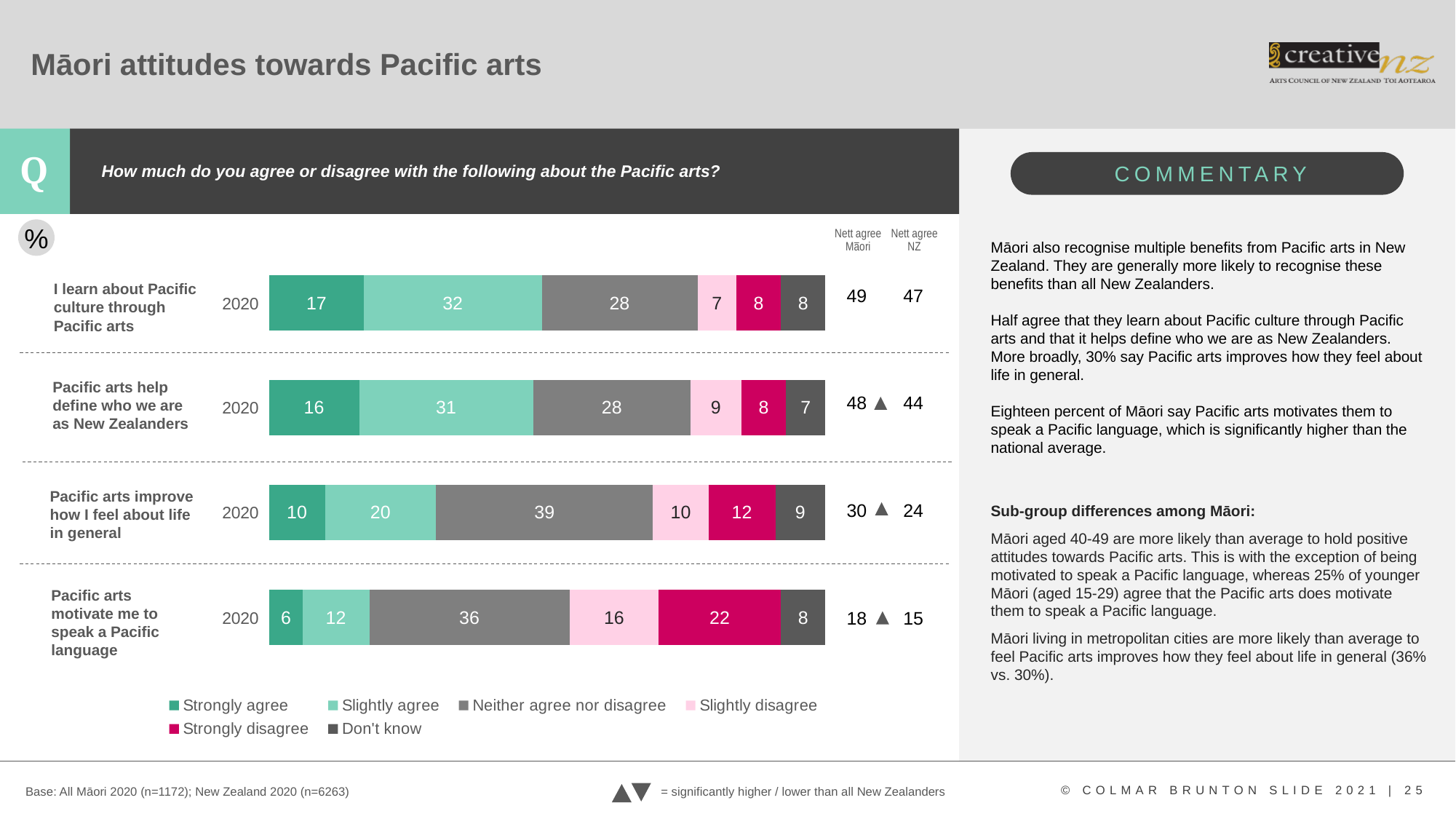
What percentage of Māori strongly disagree that Pacific arts motivate them to speak a Pacific language? 22 What is the Nett agree Māori figure for 'Pacific arts help define who we are as New Zealanders'? 48 What is the difference between the Nett agree Māori and Nett agree NZ figures for 'Pacific arts improve how I feel about life in general'? 6 What kind of chart is shown on the slide? Stacked bar chart Which statement has the highest Nett agree Māori figure? I learn about Pacific culture through Pacific arts Which is larger: the 'Slightly agree' value for 'I learn about Pacific culture through Pacific arts' or for 'Pacific arts improve how I feel about life in general'? I learn about Pacific culture through Pacific arts What is the 'Neither agree nor disagree' value for 'Pacific arts improve how I feel about life in general'? 39 What percentage of Māori strongly agree that they learn about Pacific culture through Pacific arts? 17 Which statement has the lowest 'Strongly agree' value? Pacific arts motivate me to speak a Pacific language How many series does the legend list? 6 What is the combined 'Strongly agree' and 'Slightly agree' total for 'Pacific arts motivate me to speak a Pacific language'? 18 How many statements are shown in the chart? 4